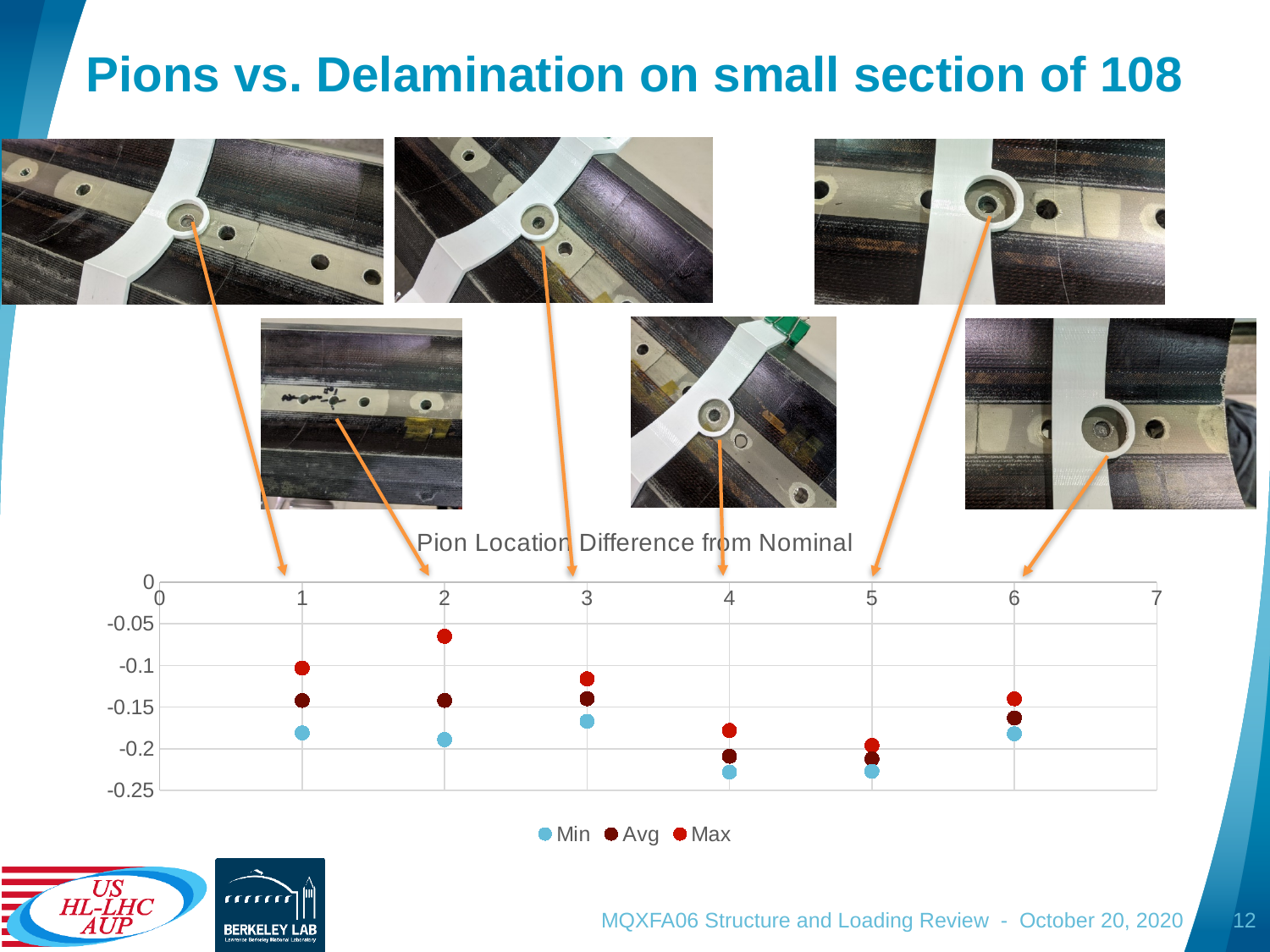
What kind of chart is shown on the slide? scatter chart At which x position is the Max series value highest? 2 Is the Avg value at x = 1 greater or less than -0.1? less Which is larger, the Min value at x = 1 or the Min value at x = 4? x = 1 At how many x positions are data points plotted in the chart? 6 Is the Max value at x = 2 greater or less than -0.1? greater How many series does the chart legend list? 3 Is the Min value at x = 4 greater or less than -0.2? less What is the title of the chart? Pion Location Difference from Nominal What are the series names listed in the chart legend? Min, Avg, Max Do the Avg values rise or fall from x = 3 to x = 4? fall